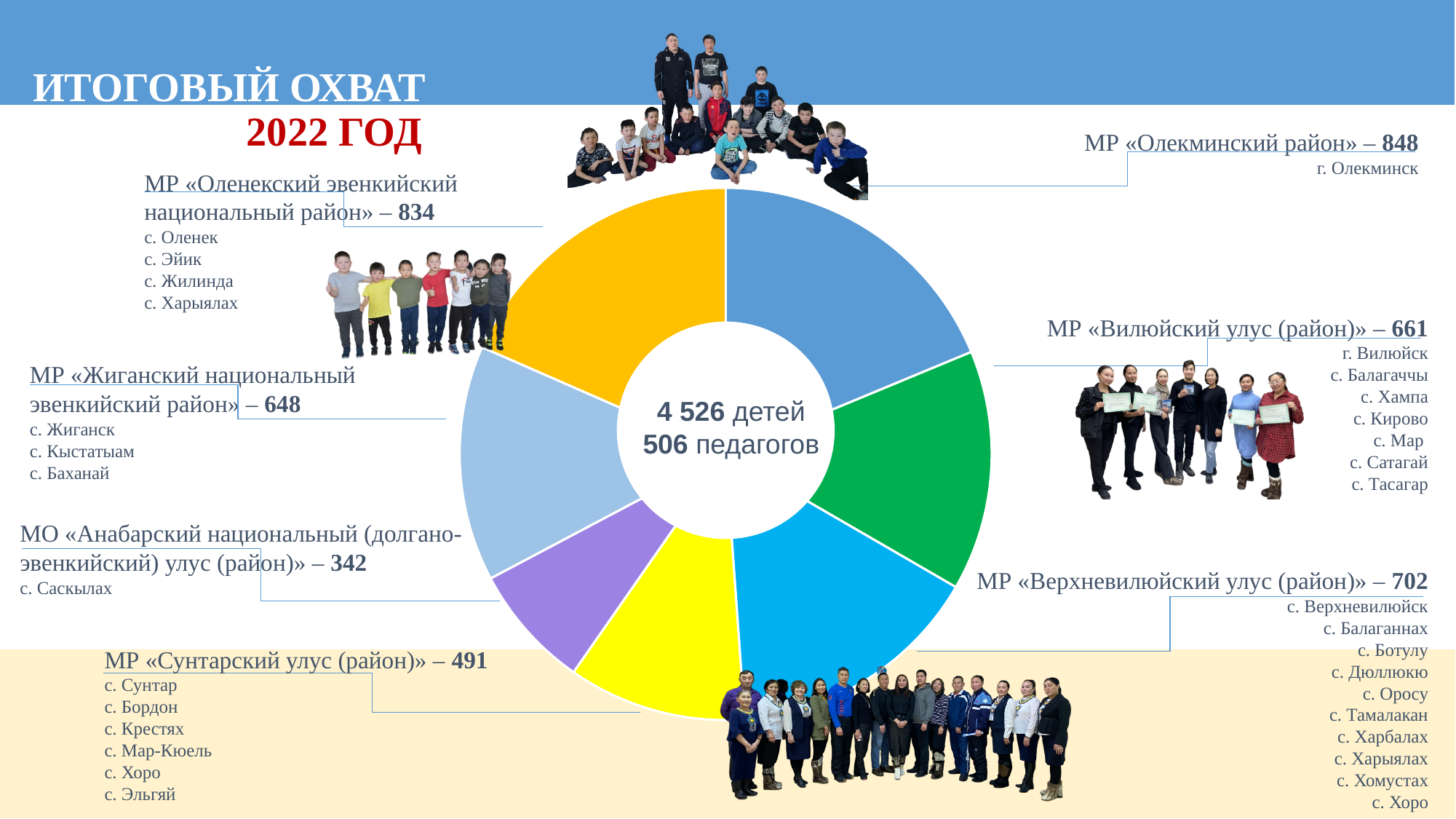
How many districts (segments) are shown on the chart? 7 What total number of children is shown in the centre of the chart? 4 526 детей What kind of chart is shown on the slide? Pie (donut) chart What is the difference between the values for МР «Верхневилюйский улус (район)» and МР «Вилюйский улус (район)»? 41 Which district has the lowest value on the chart? МО «Анабарский национальный (долгано-эвенкийский) улус (район)» What value is shown for МР «Олекминский район»? 848 Which district has the highest value on the chart? МР «Олекминский район» What value is shown for МР «Сунтарский улус (район)»? 491 Which is larger: the value for МР «Оленекский эвенкийский национальный район» or МР «Жиганский национальный эвенкийский район»? МР «Оленекский эвенкийский национальный район» What value is shown for МР «Вилюйский улус (район)»? 661 What value is shown for МО «Анабарский национальный (долгано-эвенкийский) улус (район)»? 342 How many teachers (педагогов) are stated in the centre of the chart? 506